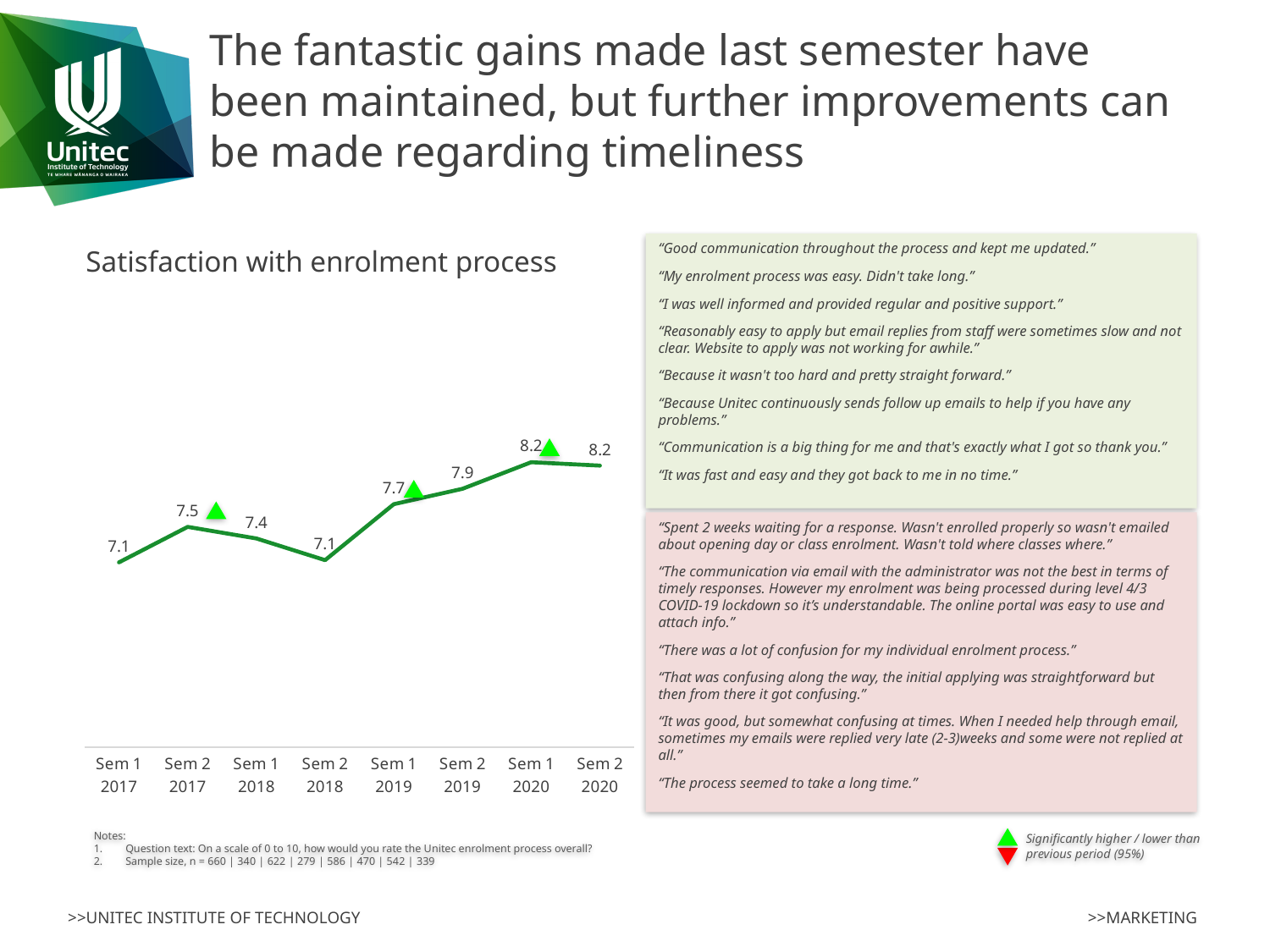
What is the satisfaction score for Sem 1 2019? 7.7 Which has the higher satisfaction score, Sem 2 2017 or Sem 1 2018? Sem 2 2017 What is the satisfaction score for Sem 2 2018? 7.1 How many semesters are plotted on the chart? 8 What kind of chart is used to show satisfaction with the enrolment process? Line chart What is the satisfaction score for Sem 2 2020? 8.2 What is the satisfaction score for Sem 2 2017? 7.5 What is the difference between the satisfaction scores for Sem 1 2020 and Sem 1 2017? 1.1 What is the title of the chart? Satisfaction with enrolment process What is the satisfaction score for Sem 1 2017? 7.1 What is the lowest satisfaction score shown on the chart? 7.1 What is the highest satisfaction score shown on the chart? 8.2